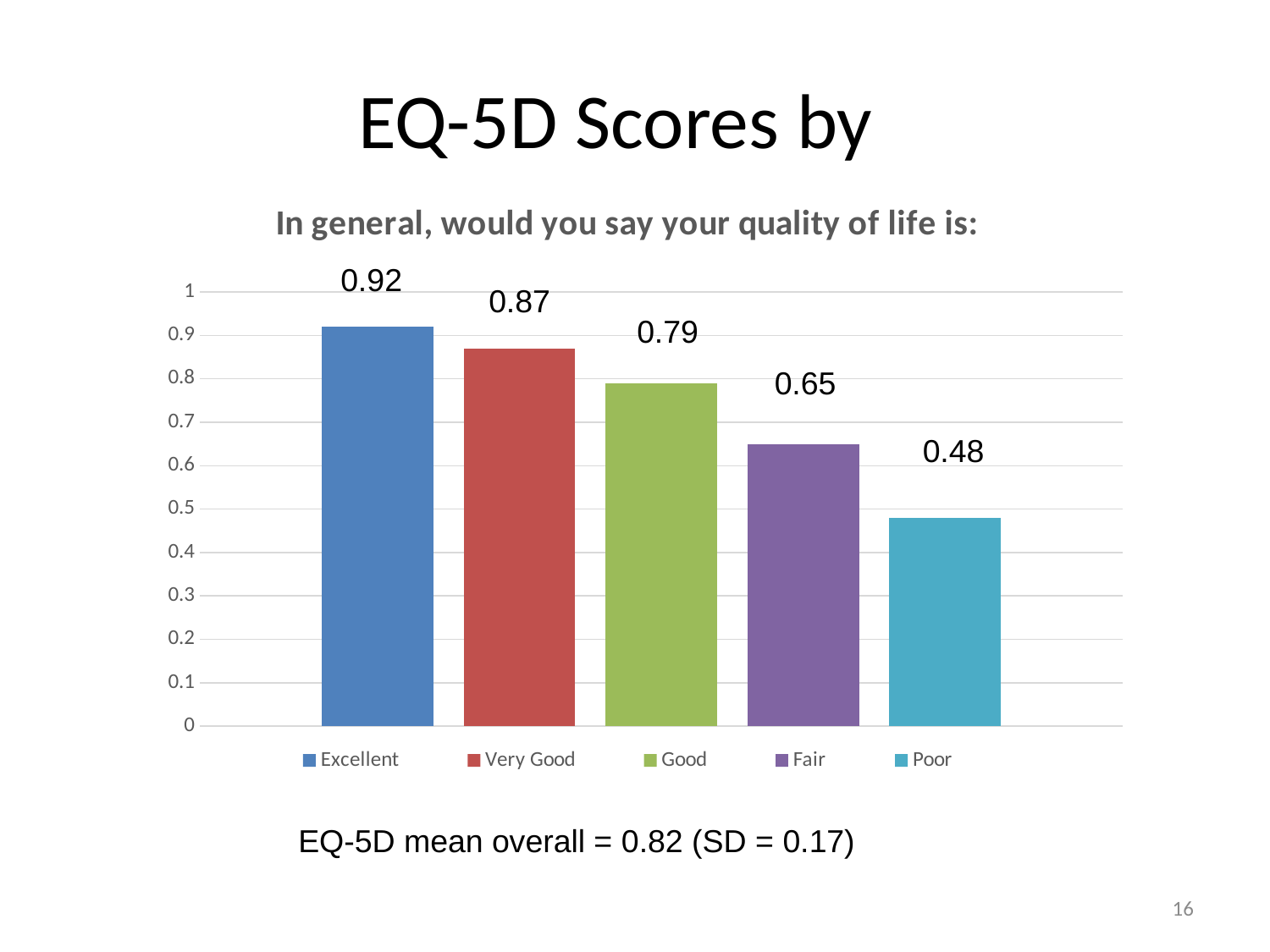
How many categories are shown in the chart? 5 What is the difference between the EQ-5D scores for Very Good and Good? 0.08 Which has a higher EQ-5D score, Good or Fair? Good Do the EQ-5D scores rise or fall from Excellent to Poor along the x axis? fall What is the EQ-5D score for the Excellent category? 0.92 Which category has the lowest EQ-5D score? Poor What is the EQ-5D score for the Fair category? 0.65 What is the difference between the EQ-5D scores for Excellent and Poor? 0.44 Which category has the highest EQ-5D score? Excellent What kind of chart is shown on the slide? bar chart Is the value for Poor greater or less than 0.5? less What is the EQ-5D score for the Poor category? 0.48